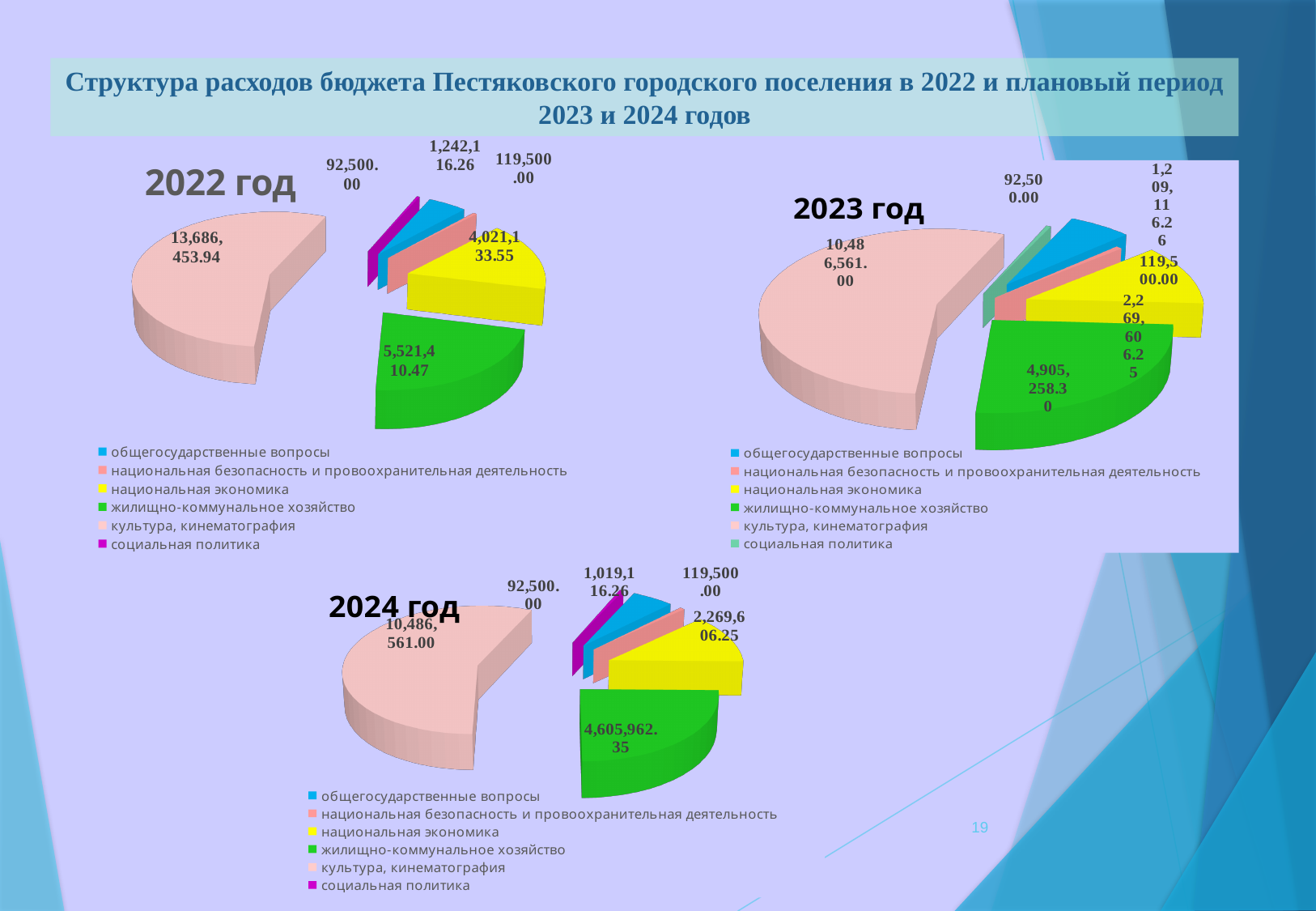
On the 2023 год chart, what is the value for жилищно-коммунальное хозяйство? 4,905,258.30 How many charts are shown on the slide? 3 On the 2022 год chart, what is the value for жилищно-коммунальное хозяйство? 5,521,410.47 On the 2022 год chart, which category has the smallest value? социальная политика On the 2024 год chart, what is the value for культура, кинематография? 10,486,561.00 On the 2024 год chart, what is the value for общегосударственные вопросы? 1,019,116.26 What kind of chart is the 2022 год chart? pie chart On the 2022 год chart, which category has the largest value? культура, кинематография How many categories does the legend of the 2023 год chart list? 6 On the 2024 год chart, which is larger: национальная экономика or жилищно-коммунальное хозяйство? жилищно-коммунальное хозяйство On the 2023 год chart, what is the value for национальная экономика? 2,269,606.25 On the 2022 год chart, what is the value for культура, кинематография? 13,686,453.94